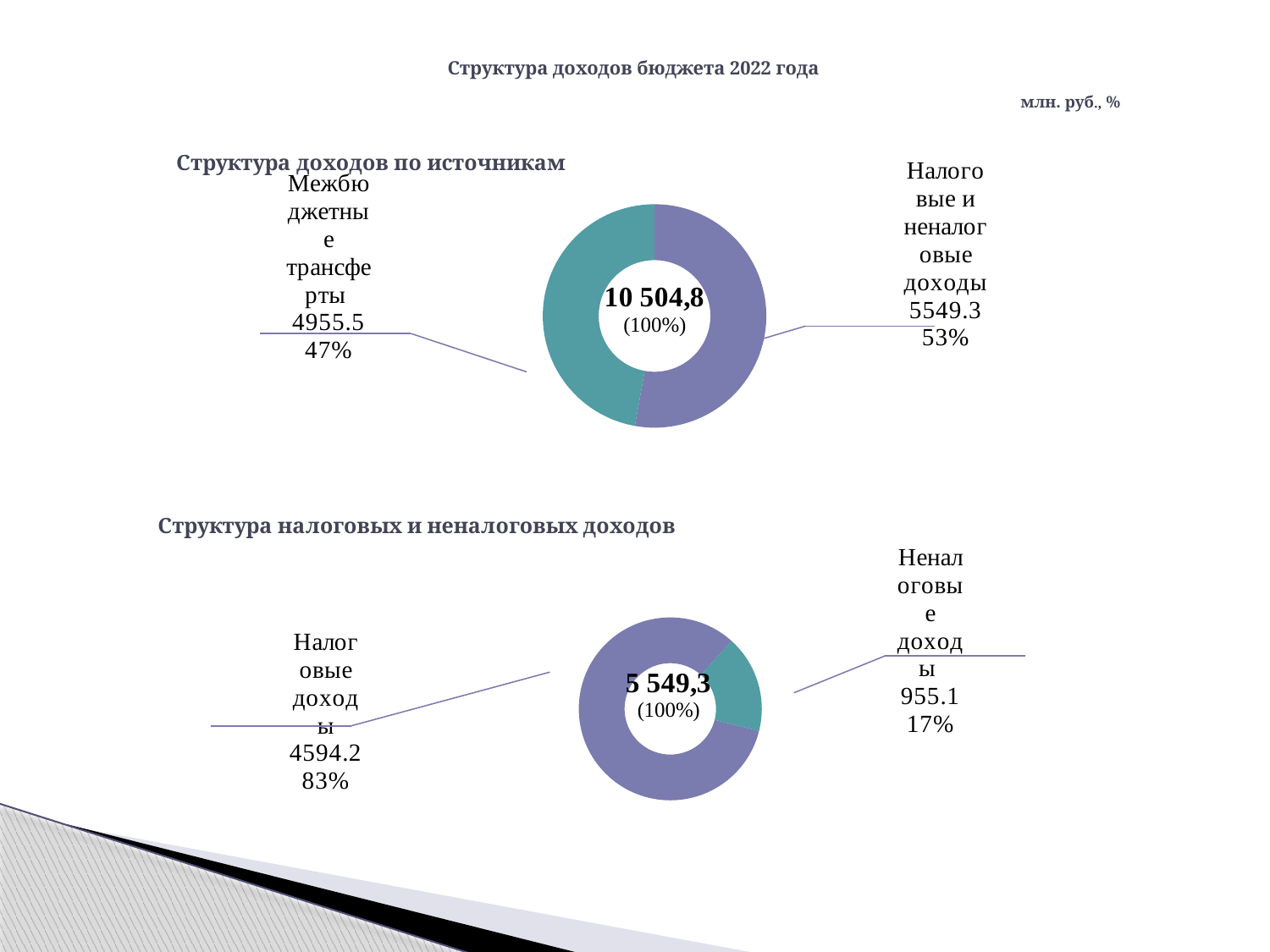
In the chart 'Структура доходов по источникам', what total is shown in the centre of the donut? 10 504,8 In the chart 'Структура доходов по источникам', what is the value for Межбюджетные трансферты? 4955.5 What is the main title of the slide? Структура доходов бюджета 2022 года In the chart 'Структура налоговых и неналоговых доходов', what is the value for Неналоговые доходы? 955.1 In the chart 'Структура доходов по источникам', which category is the largest? Налоговые и неналоговые доходы What kind of chart is used for 'Структура налоговых и неналоговых доходов'? Donut (pie) chart In the chart 'Структура налоговых и неналоговых доходов', what share of the total do Налоговые доходы make up? 83% In the chart 'Структура доходов по источникам', what is the difference between Налоговые и неналоговые доходы and Межбюджетные трансферты? 593.8 In the chart 'Структура налоговых и неналоговых доходов', what total is shown in the centre of the donut? 5 549,3 In the chart 'Структура налоговых и неналоговых доходов', which category is the smallest? Неналоговые доходы In the chart 'Структура доходов по источникам', what share of the total do Налоговые и неналоговые доходы make up? 53% In the chart 'Структура доходов по источникам', how many categories are shown? 2